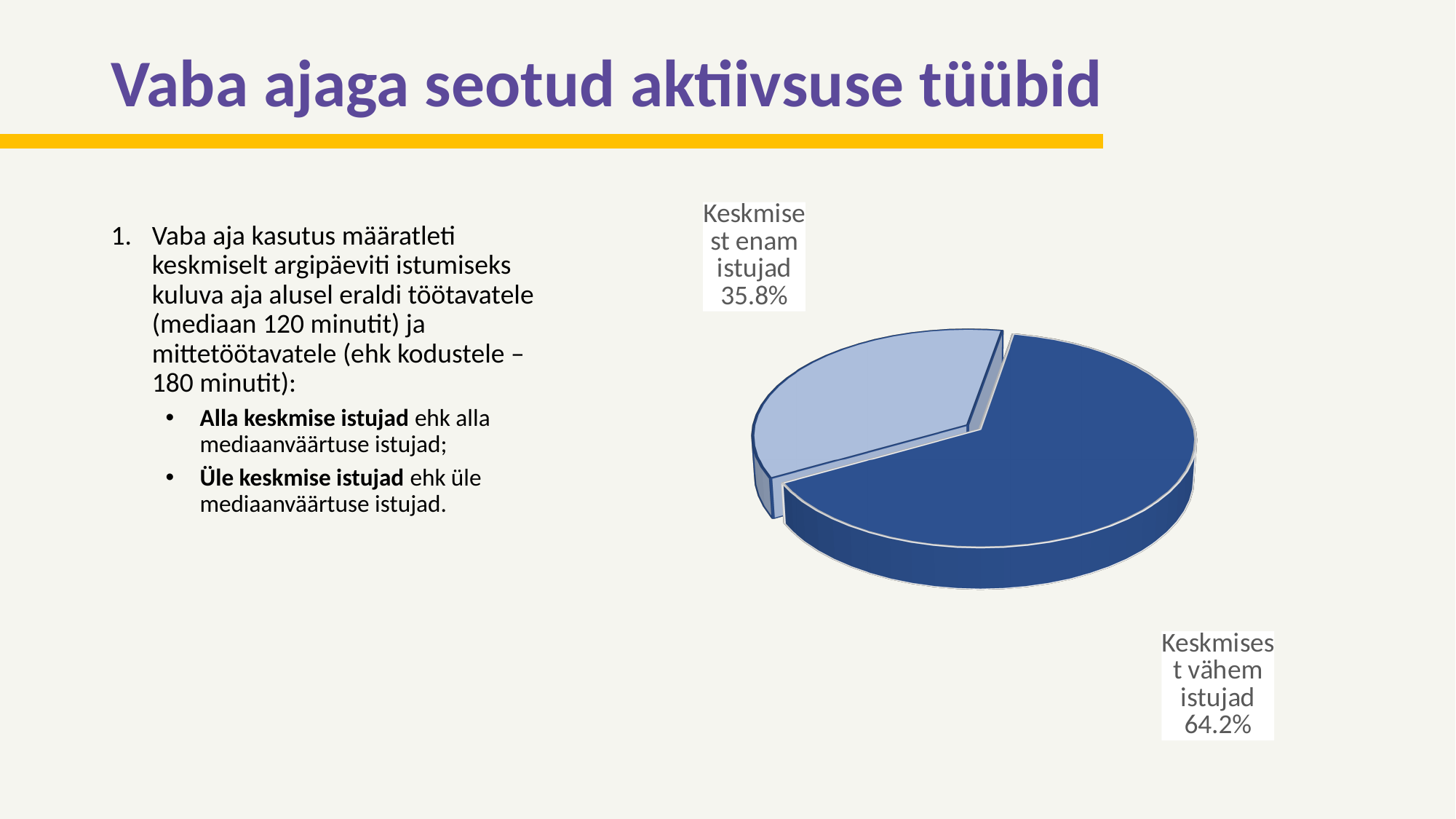
What is the difference in percentage points between the "Keskmisest vähem istujad" and "Keskmisest enam istujad" slices? 28.4 Which slice of the pie chart is the largest? Keskmisest vähem istujad Is the share for "Keskmisest enam istujad" greater or less than 50%? less Which is larger: the share for "Keskmisest enam istujad" or for "Keskmisest vähem istujad"? Keskmisest vähem istujad How many slices does the pie chart have? 2 Which slice of the pie chart is the smallest? Keskmisest enam istujad What share of the pie is labelled "Keskmisest vähem istujad"? 64.2% Is the share for "Keskmisest vähem istujad" greater or less than 50%? greater Which slice of the pie chart is shown in the lighter blue colour? Keskmisest enam istujad What is the total of the two percentages shown on the pie chart? 100% What share of the pie is labelled "Keskmisest enam istujad"? 35.8% What kind of chart is shown on the slide? Pie chart